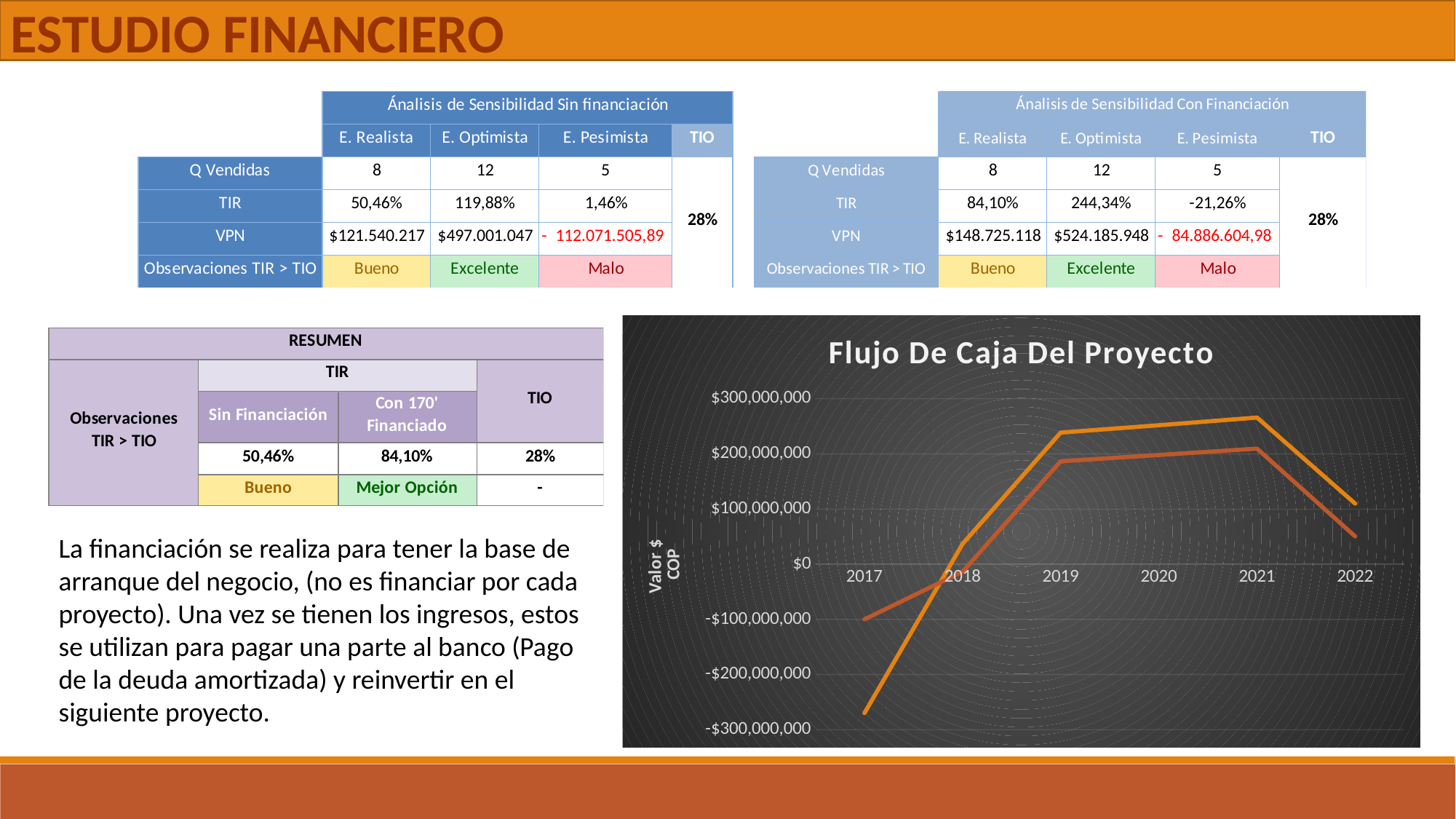
What kind of chart is 'Flujo De Caja Del Proyecto'? line chart In the 'Flujo De Caja Del Proyecto' chart, in which year does the lighter orange line reach its highest value? 2021 In the 'Flujo De Caja Del Proyecto' chart, in which year does the lighter orange line reach its lowest value? 2017 In the 'Flujo De Caja Del Proyecto' chart, is the value of the lighter orange line in 2019 greater or less than $200,000,000? greater In the 'Flujo De Caja Del Proyecto' chart, which line has the higher value in 2019, the lighter orange line or the darker red-orange line? the lighter orange line In the 'Flujo De Caja Del Proyecto' chart, is the value of the darker red-orange line in 2022 greater or less than $100,000,000? less What is the label on the vertical axis of the 'Flujo De Caja Del Proyecto' chart? Valor $ COP In the 'Flujo De Caja Del Proyecto' chart, is the value of the lighter orange line in 2017 greater or less than -$200,000,000? less How many lines are plotted in the 'Flujo De Caja Del Proyecto' chart? 2 What is the title of the chart on the slide? Flujo De Caja Del Proyecto In the 'Flujo De Caja Del Proyecto' chart, do both lines rise or fall from 2021 to 2022? fall How many years are shown on the x axis of the 'Flujo De Caja Del Proyecto' chart? 6